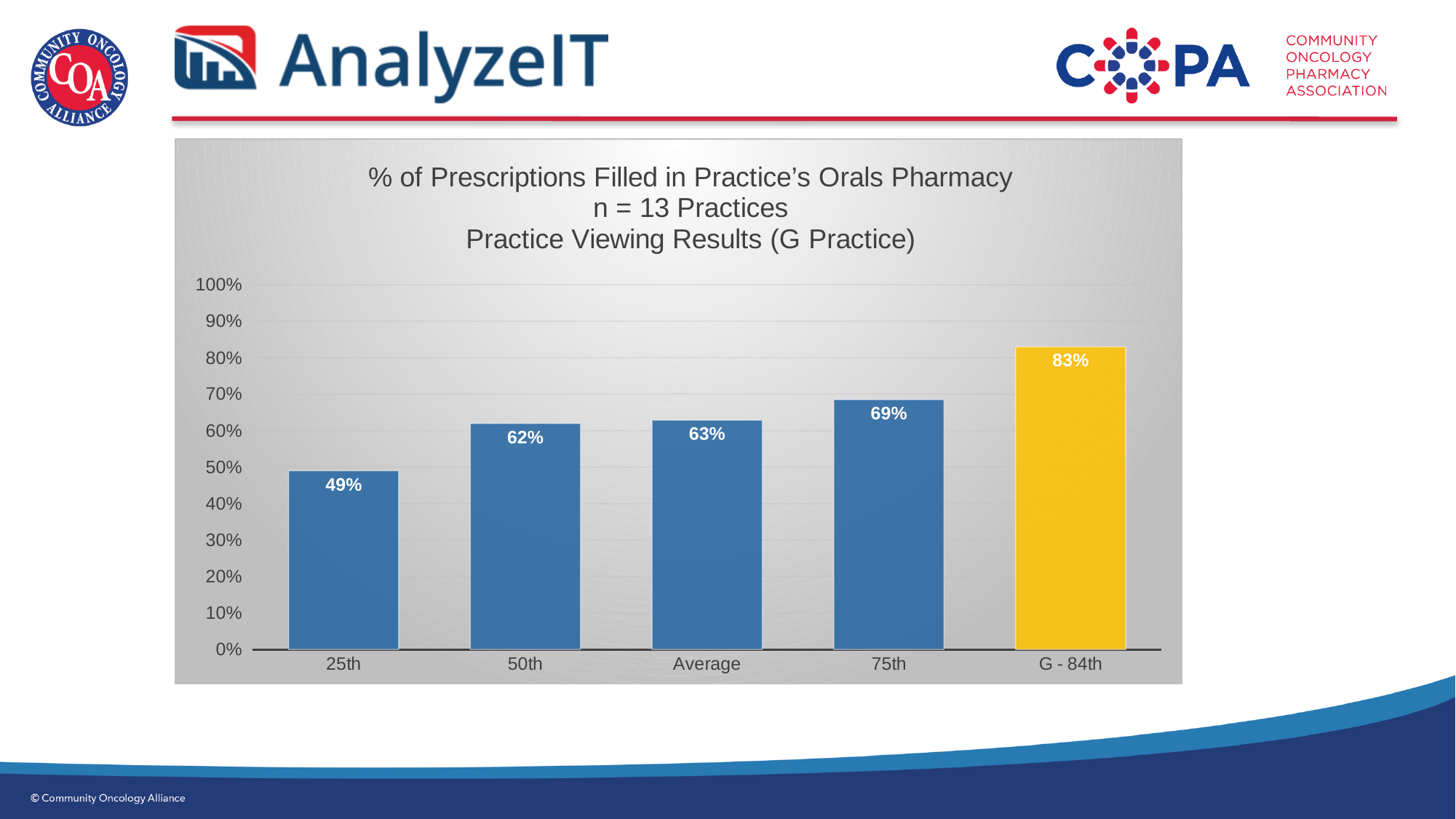
What is the difference between the G - 84th value and the 75th percentile value? 14% Which is larger, the value for 25th or the value for 50th? 50th What is the value for the 50th percentile bar? 62% Which category has the highest value? G - 84th What kind of chart is shown on the slide? Bar chart What is the value for the 25th percentile bar? 49% How many bars are shown in the chart? 5 What is the value for the 75th percentile bar? 69% What is the value for the G - 84th bar? 83% Which bar is coloured yellow rather than blue? G - 84th What is the value for the Average bar? 63% Which category has the lowest value? 25th